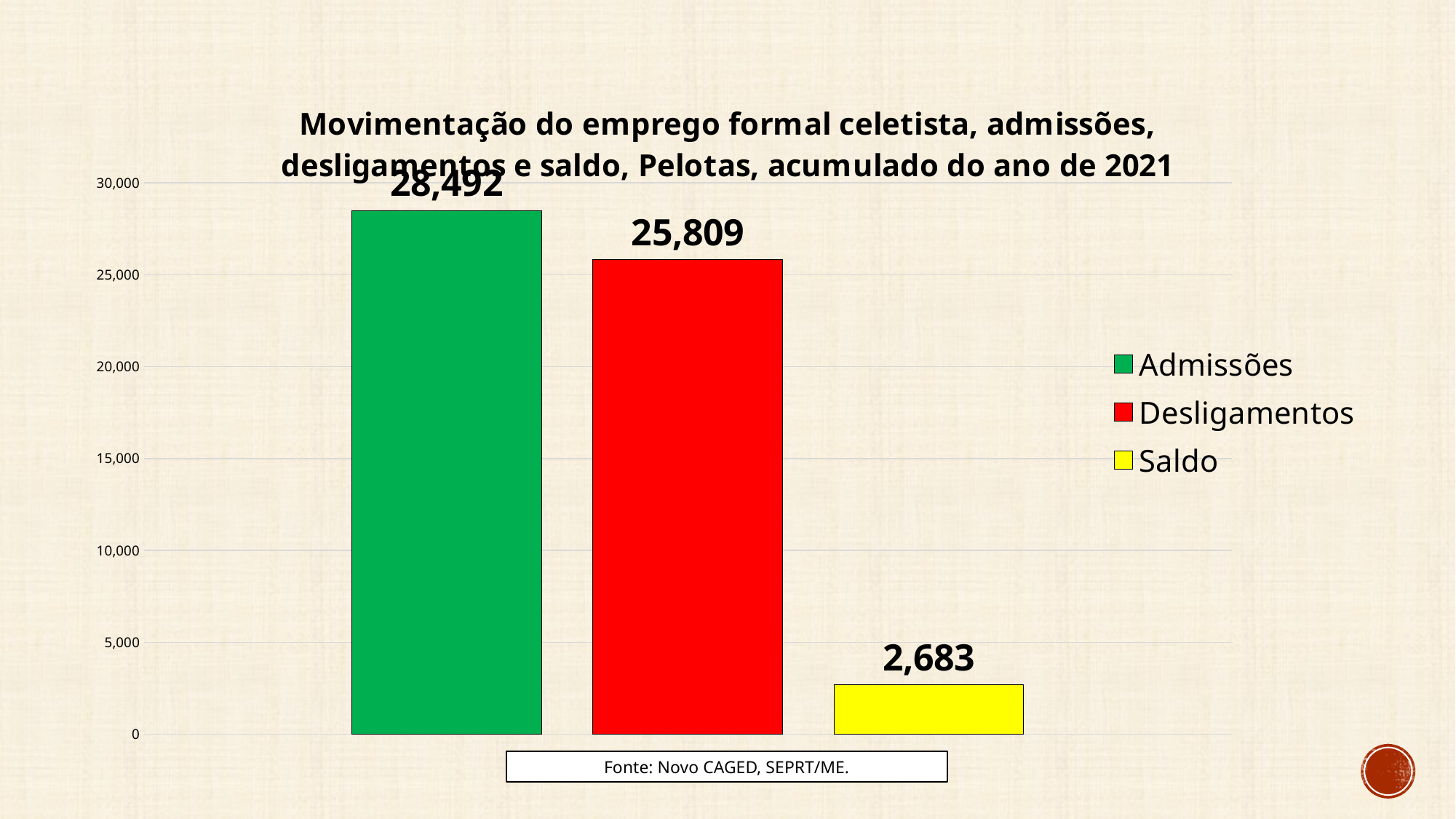
What kind of chart is shown on the slide? Bar chart Which is larger, Desligamentos or Saldo? Desligamentos What colour is the bar for Saldo? Yellow What is the value for Admissões? 28,492 What is the value for Saldo? 2,683 Which series has the highest value? Admissões What is the value for Desligamentos? 25,809 What is the difference between Admissões and Desligamentos? 2,683 How many series does the legend list? 3 Which series has the lowest value? Saldo How many bars are plotted in the chart? 3 Is the value for Desligamentos greater or less than 25,000? greater